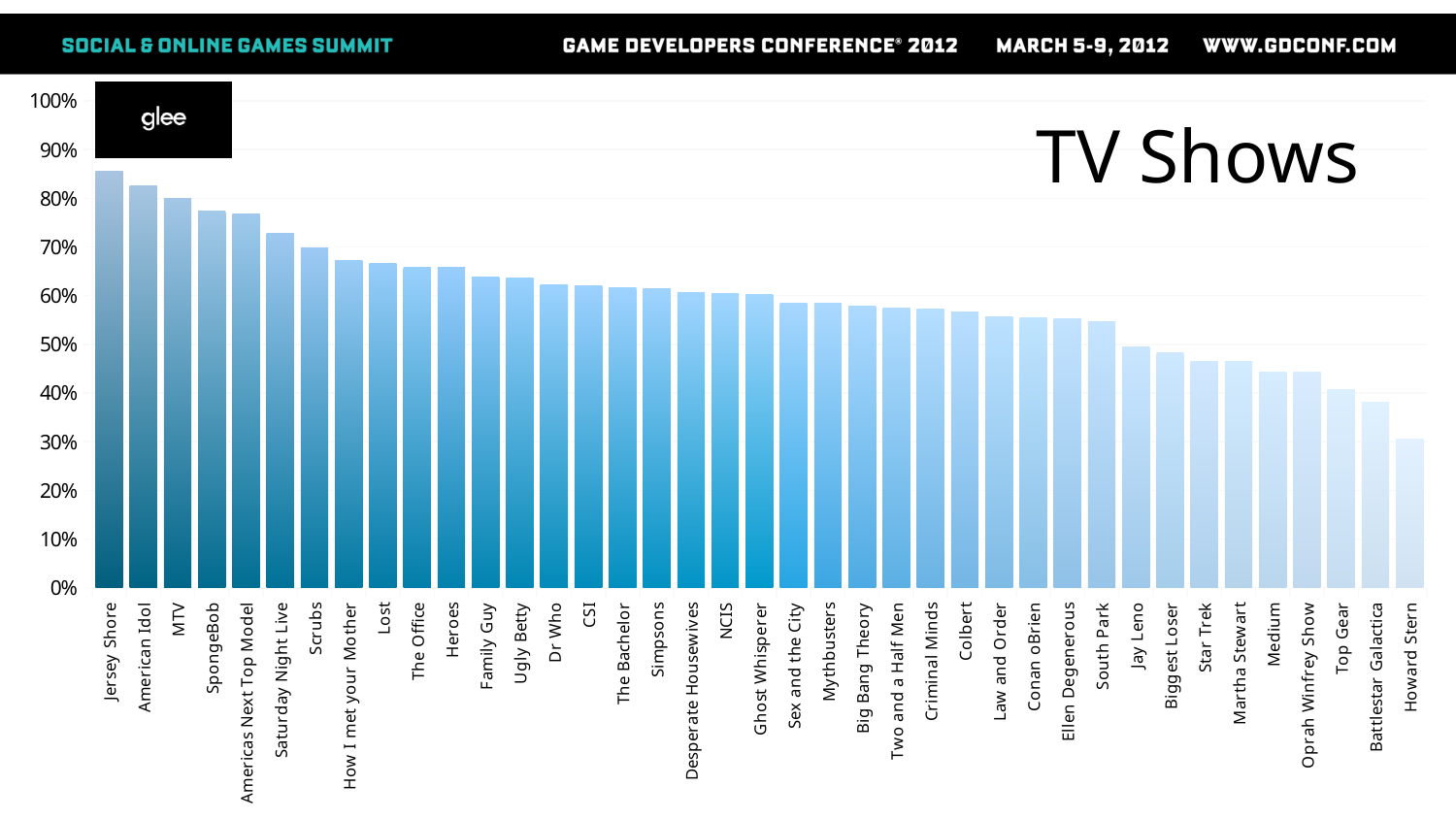
Do the values rise or fall moving from left to right along the x axis? fall How many TV shows are plotted on the chart? 39 What is the title of the chart? TV Shows Which has the larger value, MTV or SpongeBob? MTV What kind of chart is shown on the slide? bar chart Is the value for Battlestar Galactica greater or less than 40%? less Which TV show has the lowest value? Howard Stern Which TV show has the highest value? Jersey Shore Which has the larger value, Top Gear or Howard Stern? Top Gear Is the value for Howard Stern greater or less than 40%? less Is the value for Saturday Night Live greater or less than 70%? greater